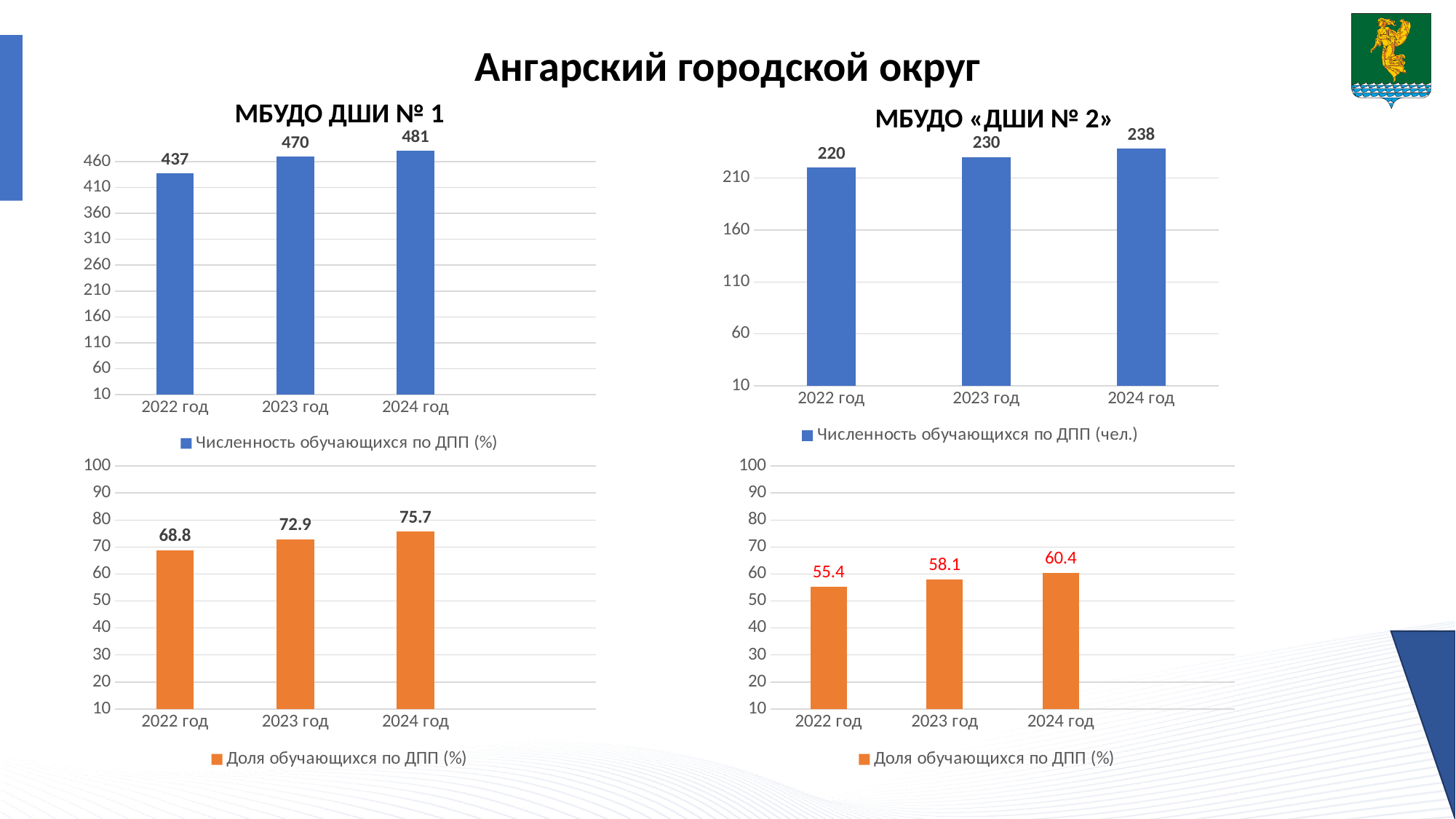
In the bottom-right chart (Доля обучающихся по ДПП, ДШИ № 2), which year has the highest value? 2024 год In the bottom-left chart (Доля обучающихся по ДПП, ДШИ № 1), is the value for 2022 год greater or less than 60? greater In the top-right chart under МБУДО «ДШИ № 2», what is the difference between the 2023 год and 2022 год values? 10 In the bottom-left chart (Доля обучающихся по ДПП, ДШИ № 1), what is the value for 2023 год? 72.9 What type of chart is the bottom-left chart (Доля обучающихся по ДПП, ДШИ № 1)? bar chart In the bottom-right chart (Доля обучающихся по ДПП, ДШИ № 2), what is the value for 2024 год? 60.4 In the top-left chart under МБУДО ДШИ № 1, what is the value for 2024 год? 481 In the bottom-right chart (Доля обучающихся по ДПП, ДШИ № 2), do the values rise or fall from 2022 год to 2024 год? rise In the top-left chart under МБУДО ДШИ № 1, which year has the lowest value? 2022 год In the top-left chart under МБУДО ДШИ № 1, what is the difference between the 2024 год and 2022 год values? 44 In the top-right chart under МБУДО «ДШИ № 2», what is the value for 2022 год? 220 How many years are shown on the x axis of the top-right chart under МБУДО «ДШИ № 2»? 3